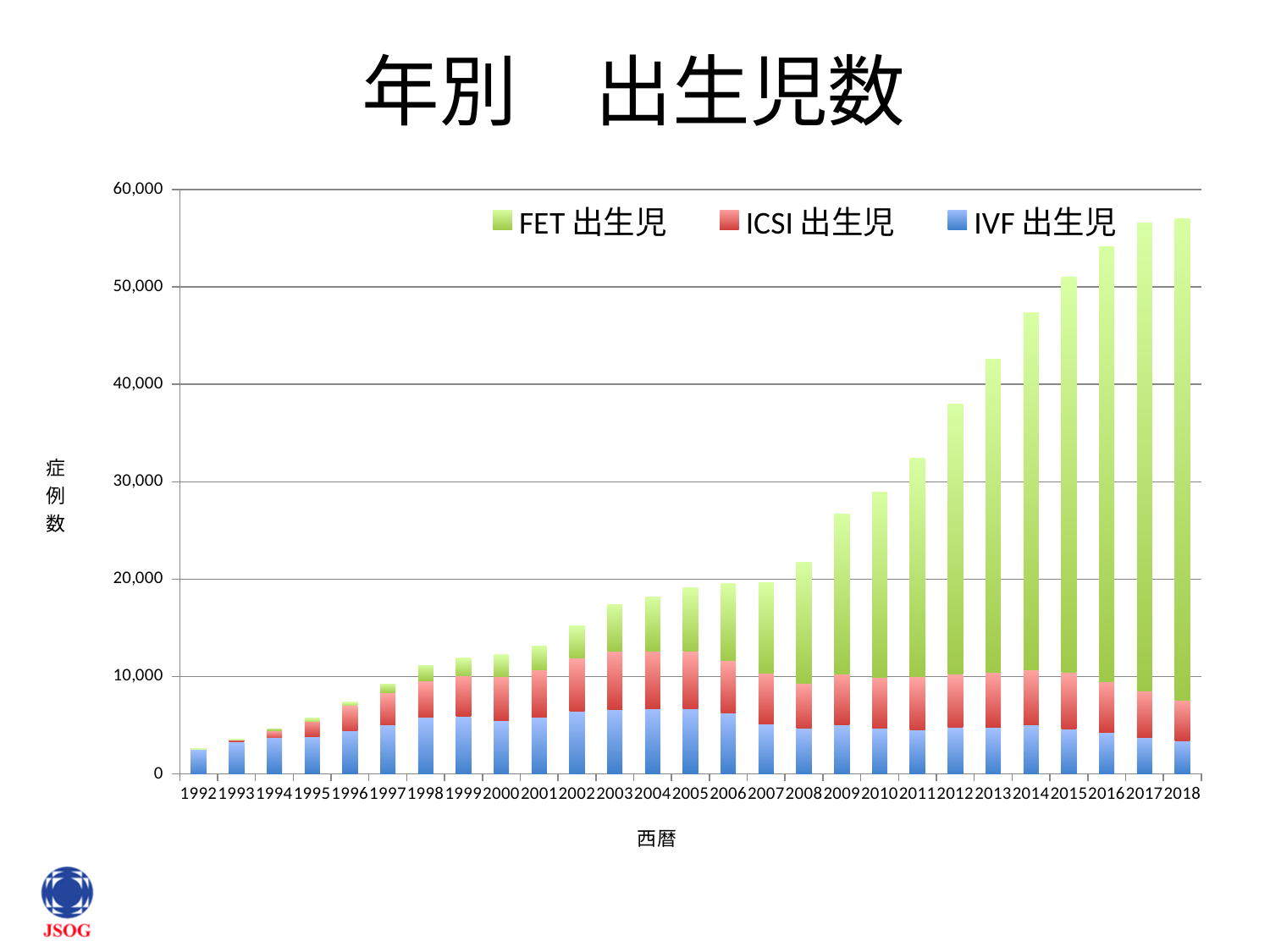
Which year has the highest total number of births? 2018 Which year has a larger total number of births, 2010 or 2018? 2018 What kind of chart is shown on the slide? stacked bar chart How many years are shown along the x axis? 27 How many series does the legend list? 3 Is the total value for 2018 greater or less than 50,000? greater Which year has the lowest total number of births? 1992 Is the total value for 2011 greater or less than 30,000? greater Do the total bar heights generally rise or fall from 1992 to 2018? rise Is the total value for 2012 greater or less than 40,000? less What is the title of the chart? 年別 出生児数